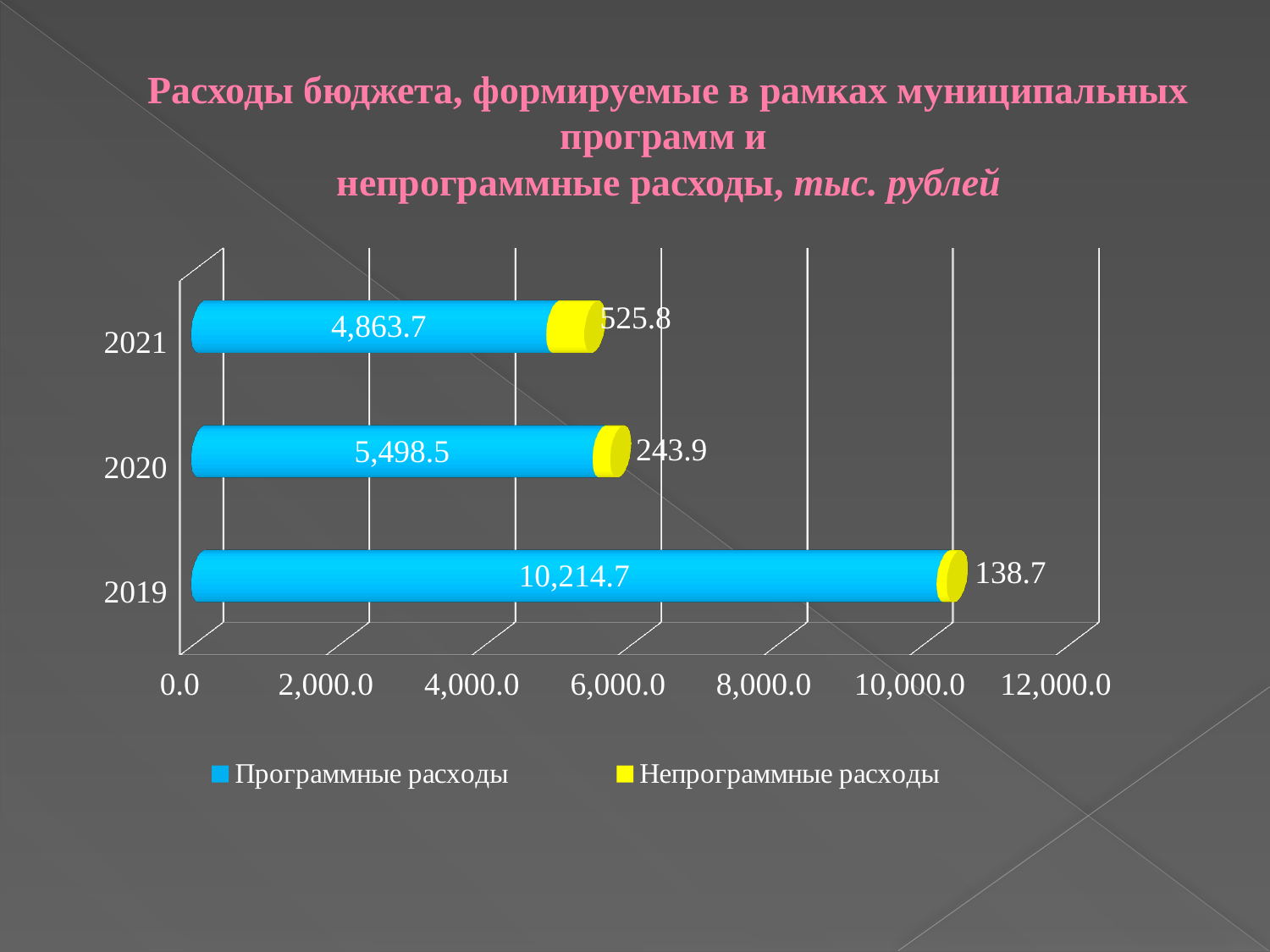
What is the value of Программные расходы for 2020? 5,498.5 What is the value of Непрограммные расходы for 2021? 525.8 What is the value of Программные расходы for 2019? 10,214.7 How many years are shown on the chart? 3 What is the total of the stacked bar for 2021? 5,389.5 Which colour represents Непрограммные расходы in the chart? Yellow Which is larger: Непрограммные расходы in 2021 or in 2020? 2021 How many series does the legend list? 2 What is the difference between Программные расходы in 2019 and in 2020? 4,716.2 What kind of chart is shown on the slide? Stacked bar chart Which year has the highest value of Программные расходы? 2019 Which year has the lowest value of Непрограммные расходы? 2019